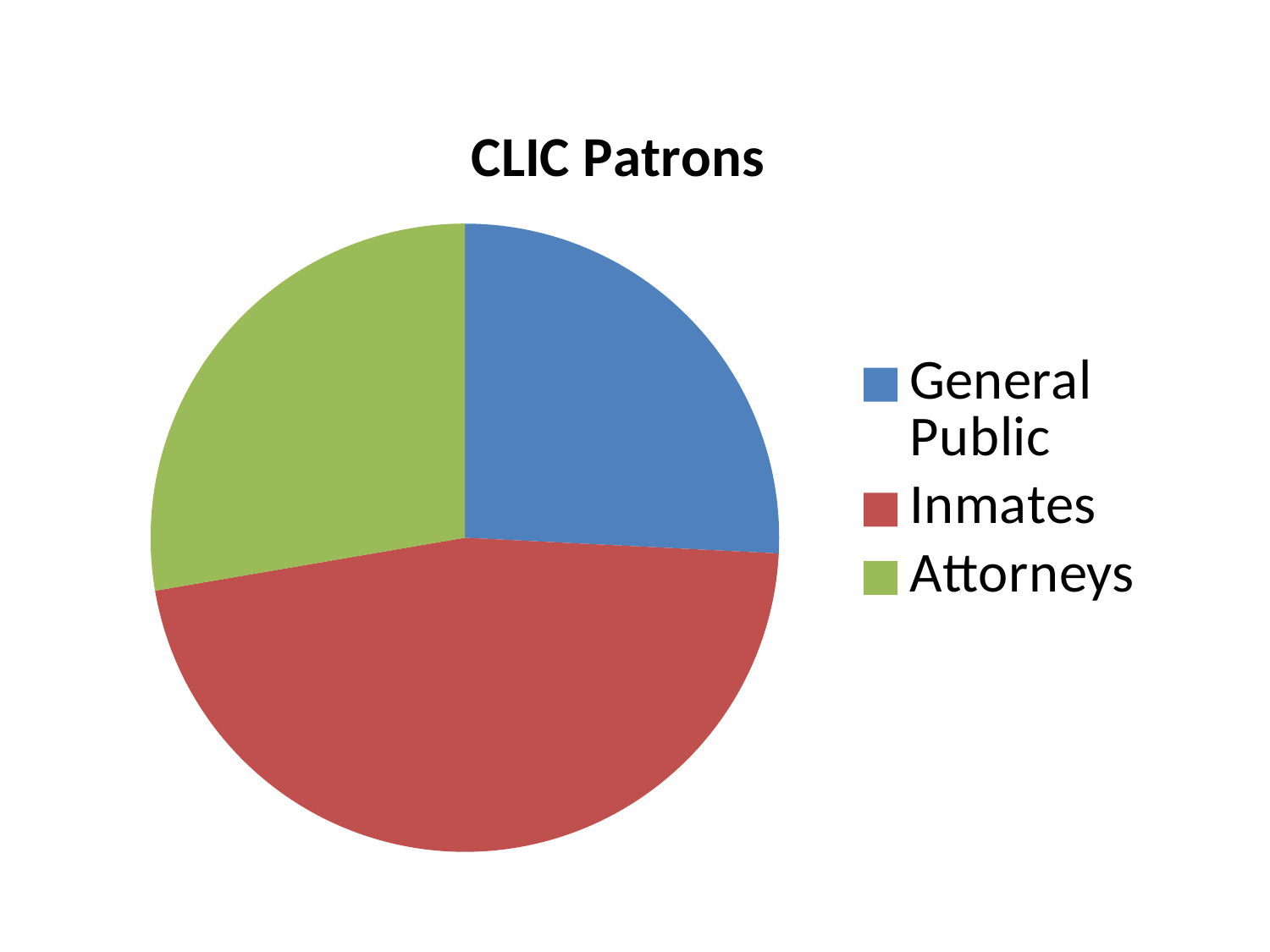
What is the title of the chart? CLIC Patrons How many entries does the legend list? 3 What kind of chart is shown on the slide? pie chart How many categories does the pie chart show? 3 Which category has the largest slice of the pie? Inmates Which slice is larger, Inmates or General Public? Inmates Which slice is larger, Inmates or Attorneys? Inmates Which colour represents Attorneys in the pie chart? green